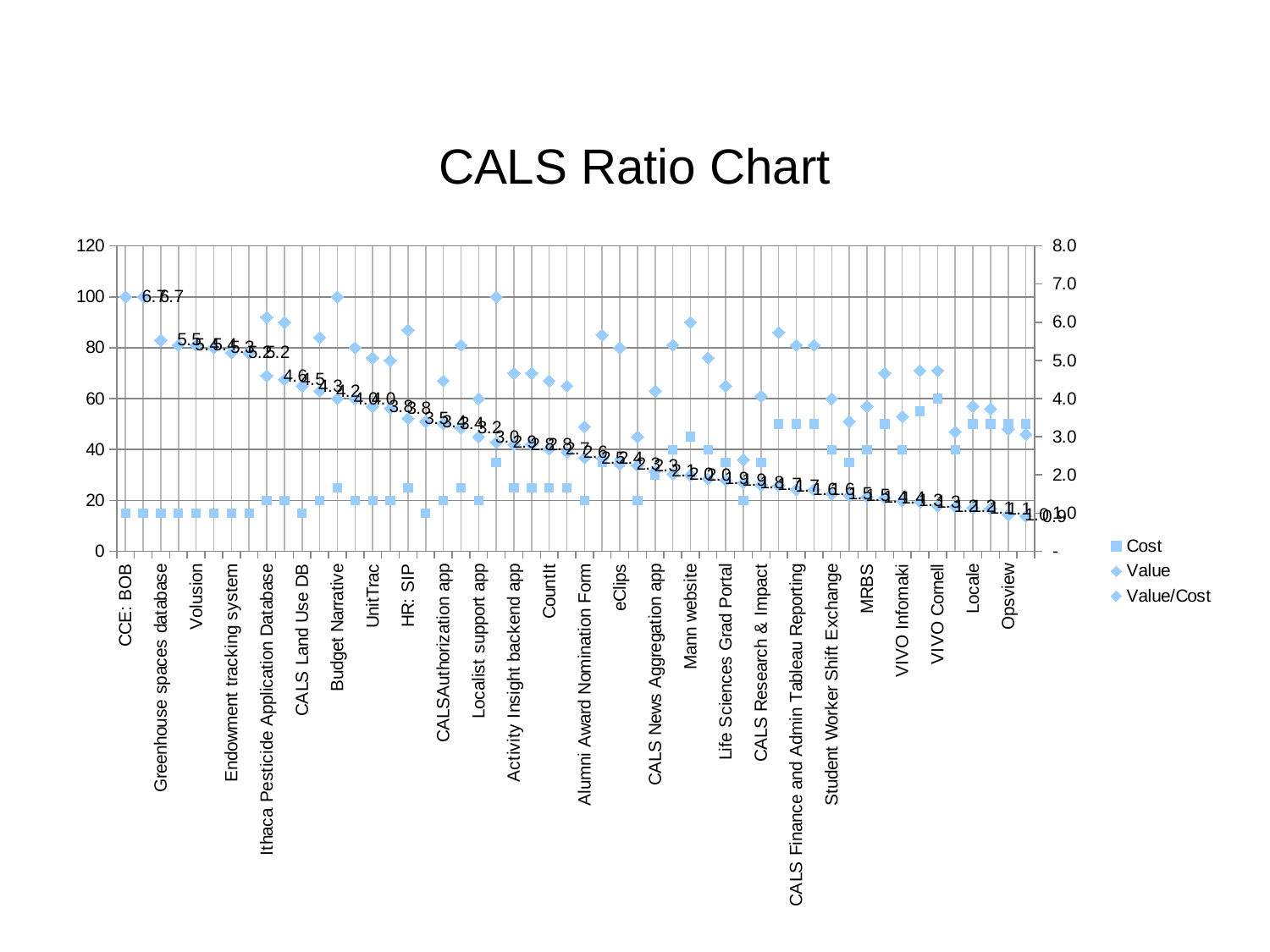
Is the Value/Cost ratio for Opsview greater or less than 2.0? less What kind of chart is shown on the slide? Scatter chart Which is larger, the Value for CCE: BOB or the Value for Opsview? CCE: BOB How many series does the legend list? 3 Which category has the highest Value/Cost ratio? CCE: BOB Which category has the highest Cost? VIVO Cornell Is the Cost for CCE: BOB greater or less than 20? less What is the title of the chart? CALS Ratio Chart Which is larger, the Cost for CCE: BOB or the Cost for VIVO Cornell? VIVO Cornell Do the Value/Cost values rise or fall from left to right along the x axis? Fall What is the Value/Cost ratio for CCE: BOB? 6.7 Is the Value for Budget Narrative greater or less than 80? greater